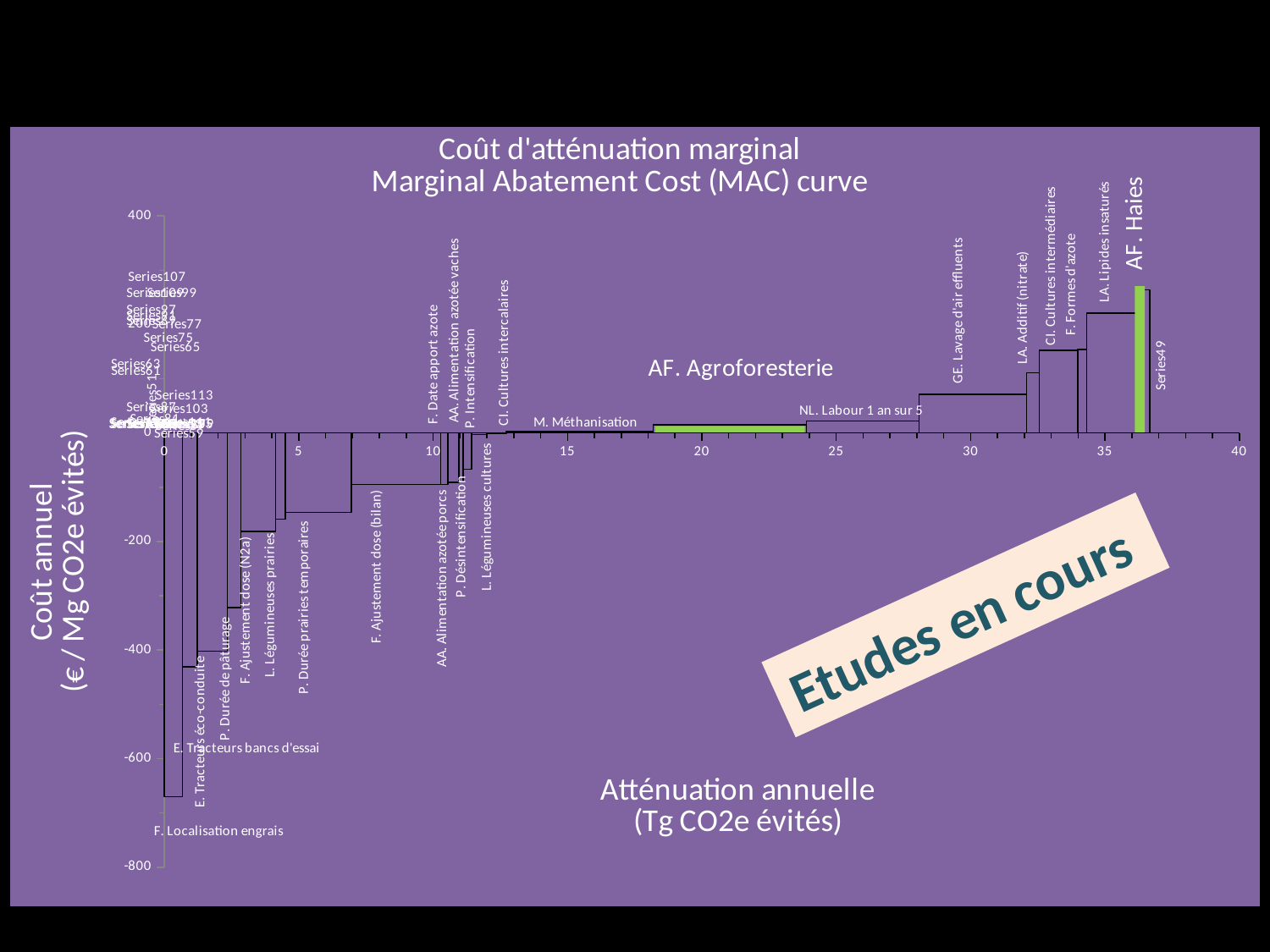
Is the annual cost for E. Tracteurs bancs d'essai greater or less than -400 € / Mg CO2e évités? less Is the annual cost for AF. Haies greater or less than 200 € / Mg CO2e évités? greater What is the title of the chart? Coût d'atténuation marginal / Marginal Abatement Cost (MAC) curve Which measure has the highest annual cost (€ / Mg CO2e évités) on the chart? AF. Haies Which measure has the lowest (most negative) annual cost on the chart? F. Localisation engrais What kind of chart is shown on the slide? bar chart What is the label of the x axis? Atténuation annuelle (Tg CO2e évités) Which has the higher annual cost, AF. Haies or LA. Lipides insaturés? AF. Haies Is the annual cost for F. Localisation engrais greater or less than -600 € / Mg CO2e évités? less Do the annual cost values rise or fall as you move from left to right along the x axis? rise Which has the lower annual cost, F. Localisation engrais or P. Durée de pâturage? F. Localisation engrais Which two measures are highlighted in green on the chart? AF. Agroforesterie and AF. Haies